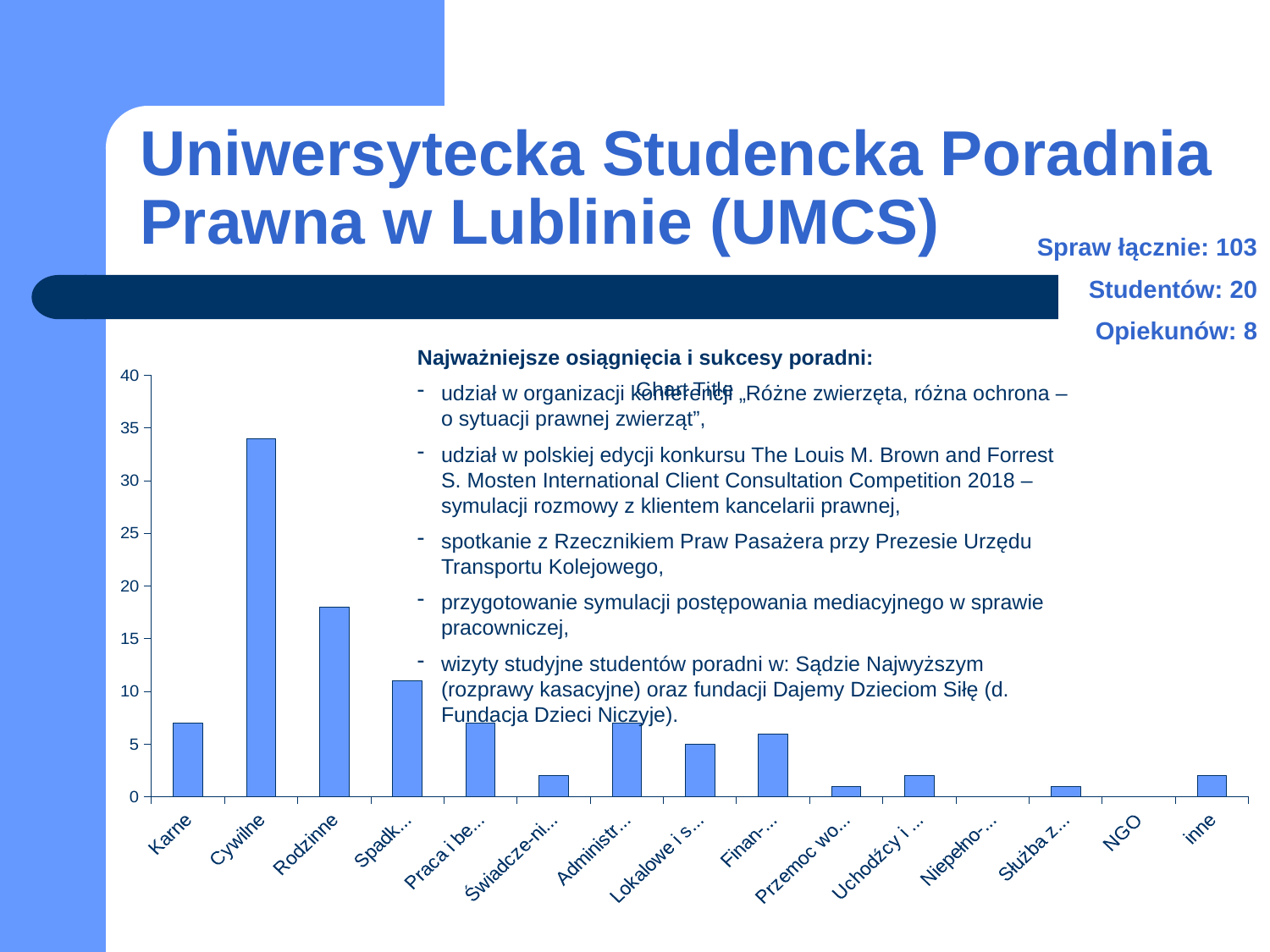
What title is displayed above the chart? Chart Title Which is larger, the value for Rodzinne or the value for Karne? Rodzinne Which is larger, the value for Karne or the value for inne? Karne Is the value for Rodzinne greater or less than 20? less Is the value for Cywilne greater or less than 30? greater Is the value for Karne greater or less than 10? less What kind of chart is shown on the slide? bar chart How many categories are shown on the x axis of the chart? 15 Which category has the highest bar in the chart? Cywilne Which is larger, the value for Cywilne or the value for Rodzinne? Cywilne